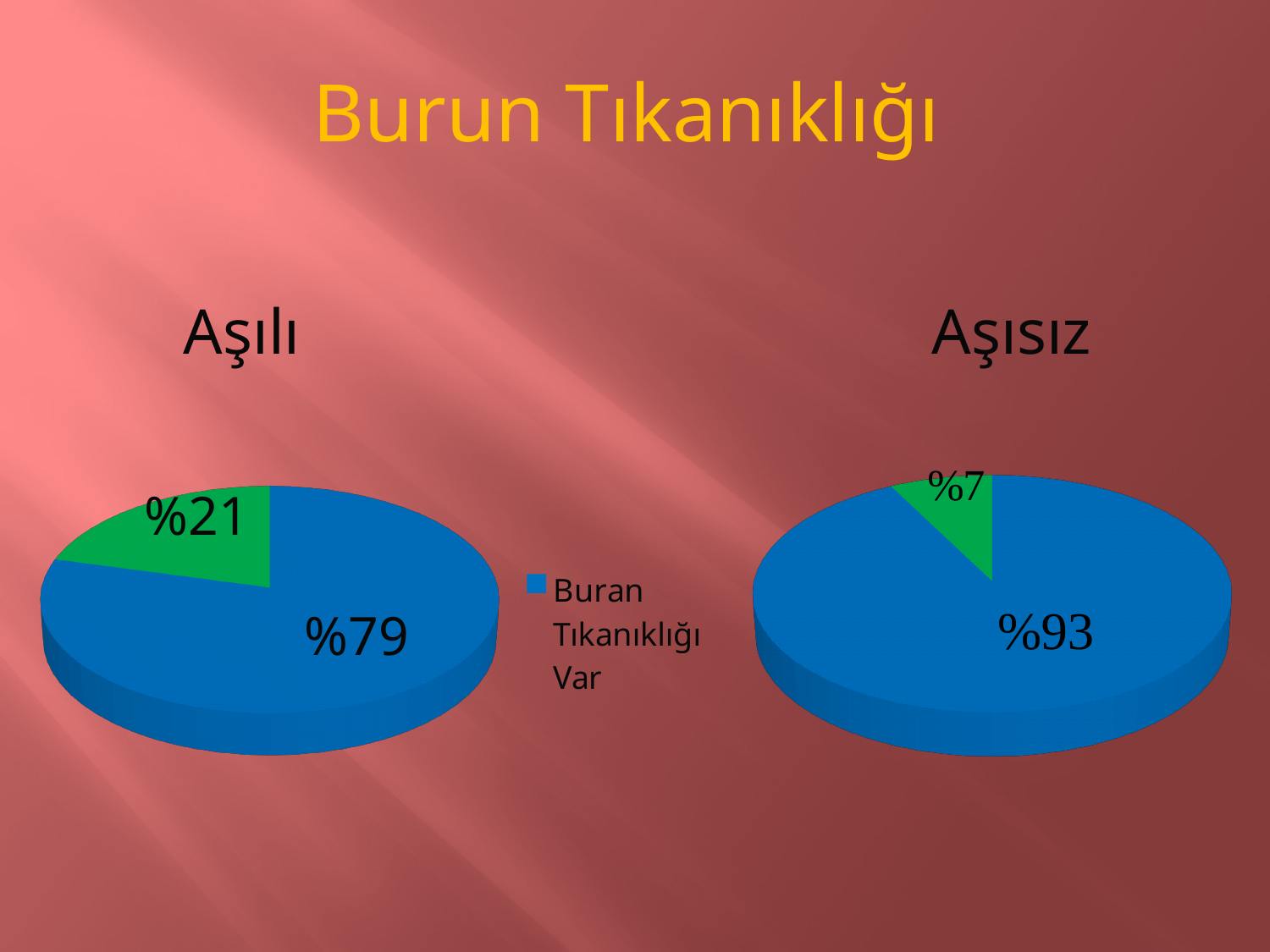
In the "Aşılı" pie chart, what value is printed on the blue slice? %79 Which pie chart has the larger blue slice, "Aşılı" or "Aşısız"? Aşısız In the "Aşısız" pie chart, what value is printed on the green slice? %7 What is the difference between the blue slice values of the "Aşısız" and "Aşılı" pie charts? %14 In the "Aşılı" pie chart, what value is printed on the green slice? %21 What legend entry is shown for the blue slices of the pie charts? Buran Tıkanıklığı Var What kind of chart is shown under the heading "Aşılı"? pie chart In the "Aşılı" pie chart, which slice is the largest? the blue slice (%79) How many slices does the "Aşılı" pie chart have? 2 What is the title of the slide containing the two pie charts? Burun Tıkanıklığı In the "Aşısız" pie chart, which slice is the smallest? the green slice (%7) In the "Aşısız" pie chart, what value is printed on the blue slice? %93